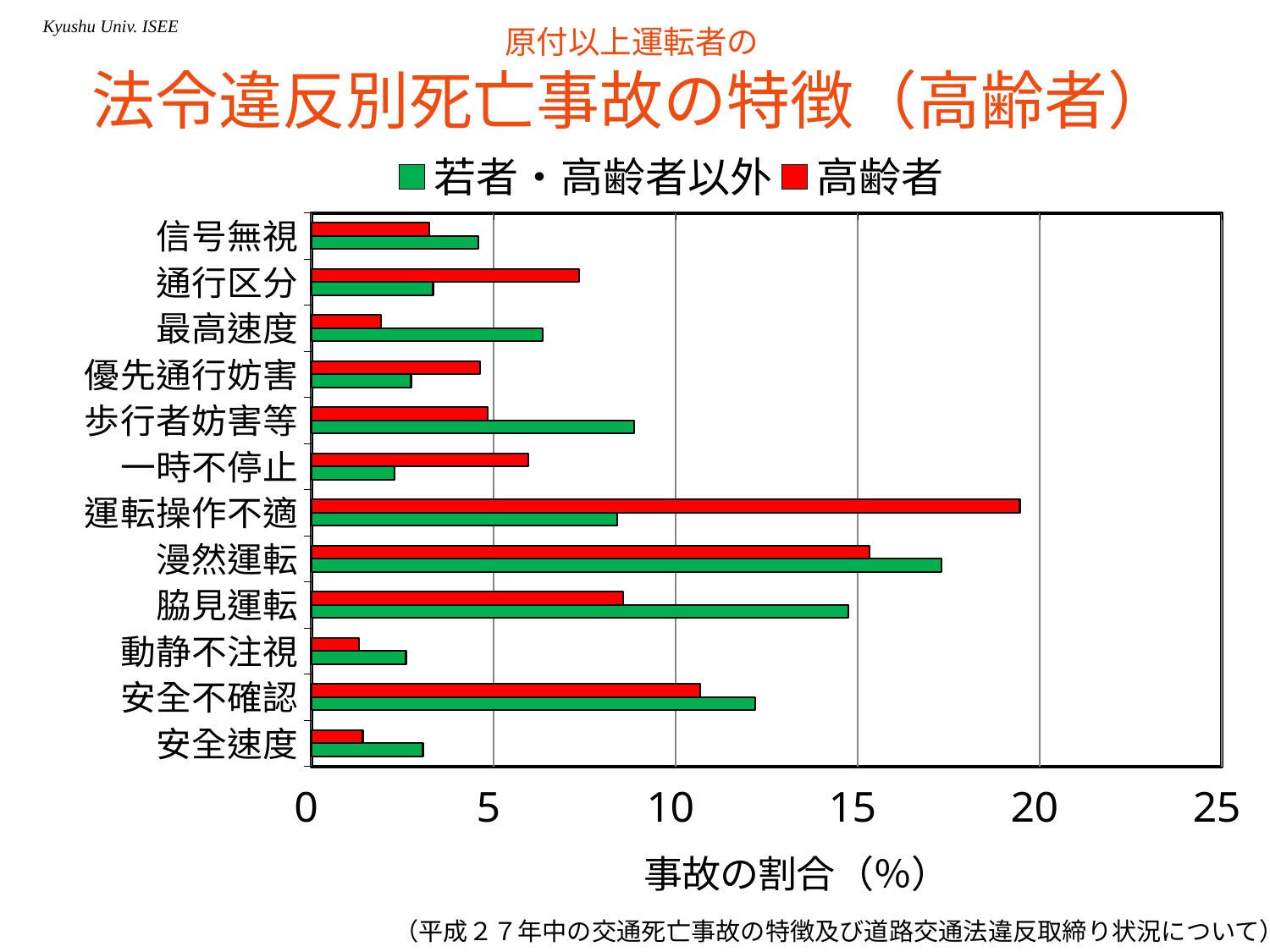
Is the 若者・高齢者以外 value for 脇見運転 greater or less than 10? greater How many series does the legend list? 2 For 一時不停止, which series has the larger value, 若者・高齢者以外 or 高齢者? 高齢者 Which category has the highest value for the 高齢者 series? 運転操作不適 Is the 高齢者 value for 運転操作不適 greater or less than 15? greater For 脇見運転, which series has the larger value, 若者・高齢者以外 or 高齢者? 若者・高齢者以外 Is the 若者・高齢者以外 value for 安全不確認 greater or less than 10? greater Which category has the highest value for the 若者・高齢者以外 series? 漫然運転 How many violation categories are plotted on the y axis? 12 What colour represents the 高齢者 series in the chart? red What kind of chart is shown on the slide? bar chart